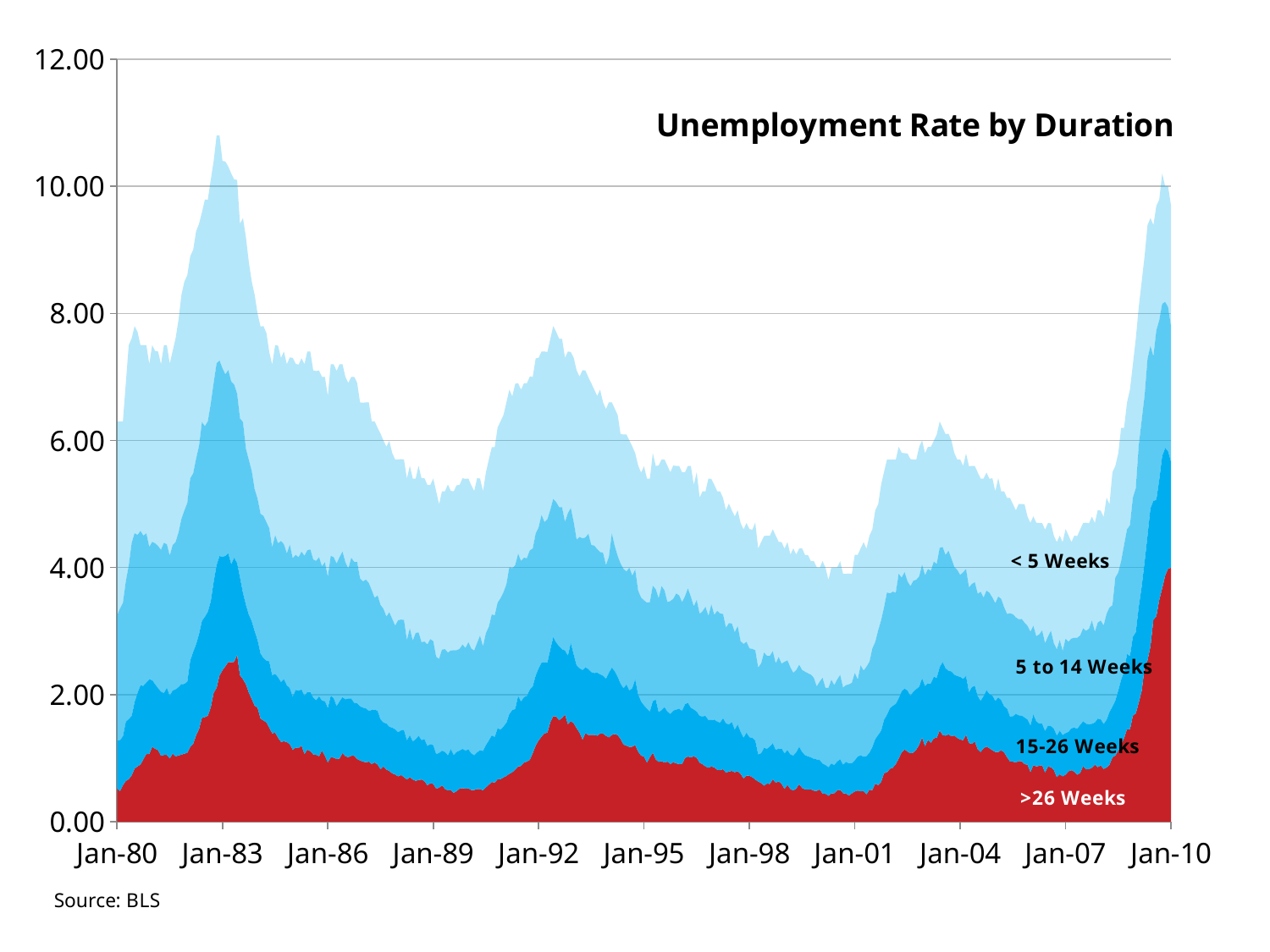
Does the total unemployment rate rise or fall between Jan-92 and Jan-01? fall Is the total unemployment rate around Jan-01 greater or less than 6.00? less Which series is shown in red at the bottom of the stack? >26 Weeks Is the overall peak near Jan-83 higher or lower than the peak near Jan-10? higher What kind of chart is shown on the slide? Stacked area chart What is the title of the chart? Unemployment Rate by Duration Is the >26 Weeks value at its peak near Jan-83 greater or less than 2.00? greater Does the total unemployment rate rise or fall between Jan-07 and Jan-10? rise Is the total unemployment rate at its peak near Jan-83 greater or less than 10.00? greater How many duration series are plotted in the chart? 4 What is the highest value shown on the y axis? 12.00